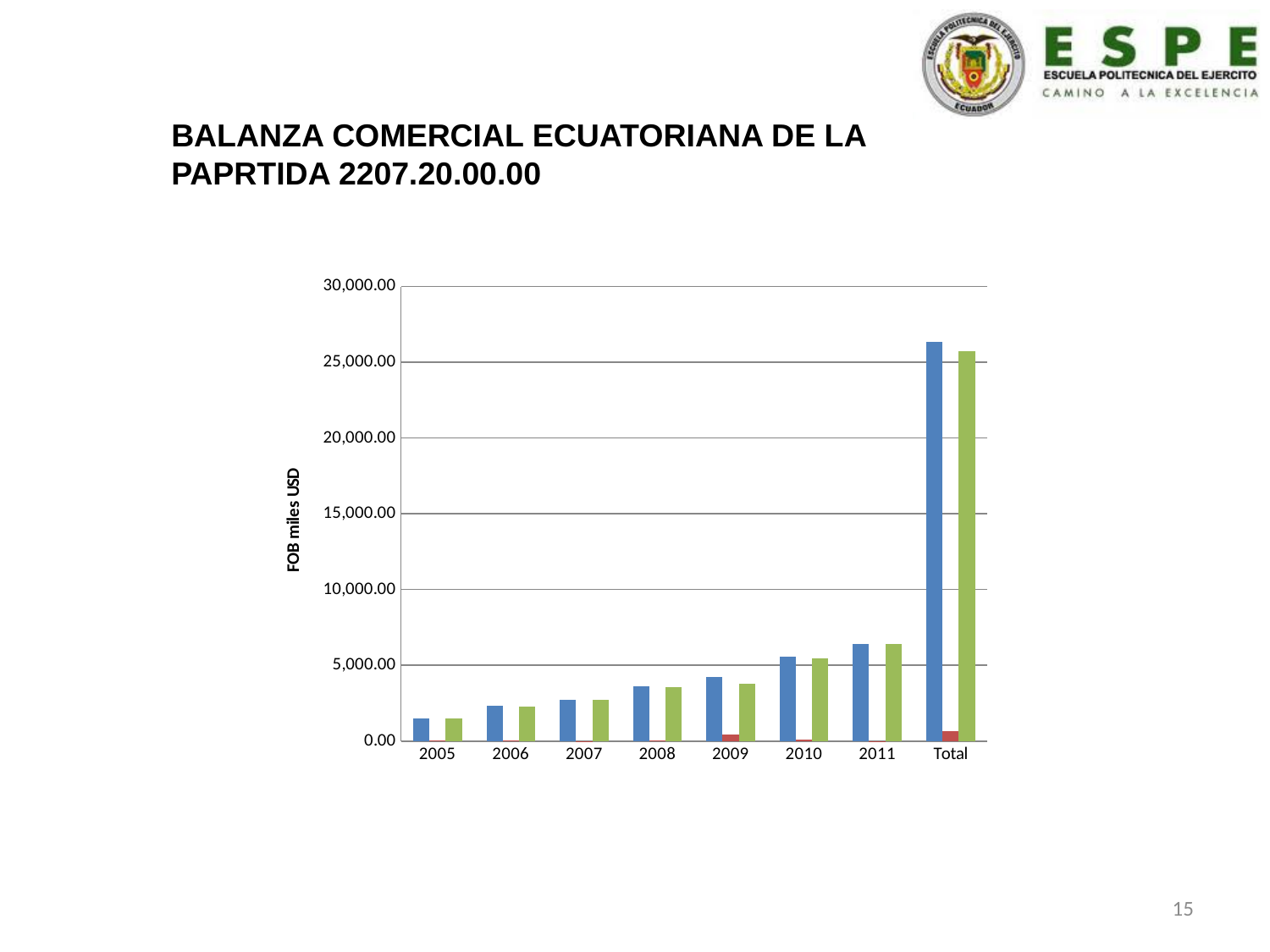
How many categories are shown on the x axis of the chart? 8 Is the value of the green bar for 2008 greater or less than 5,000.00? less What kind of chart is shown on the slide? bar chart Among the years 2005 to 2011, which year has the lowest green bar? 2005 What is the label of the vertical axis of the chart? FOB miles USD Is the value of the green bar for Total greater or less than 25,000.00? greater Is the value of the blue bar for Total greater or less than 25,000.00? greater Among the years 2005 to 2011, which year has the highest blue bar? 2011 Do the blue bars rise or fall from 2005 to 2011? rise How many differently coloured bars are shown for each category in the chart? 3